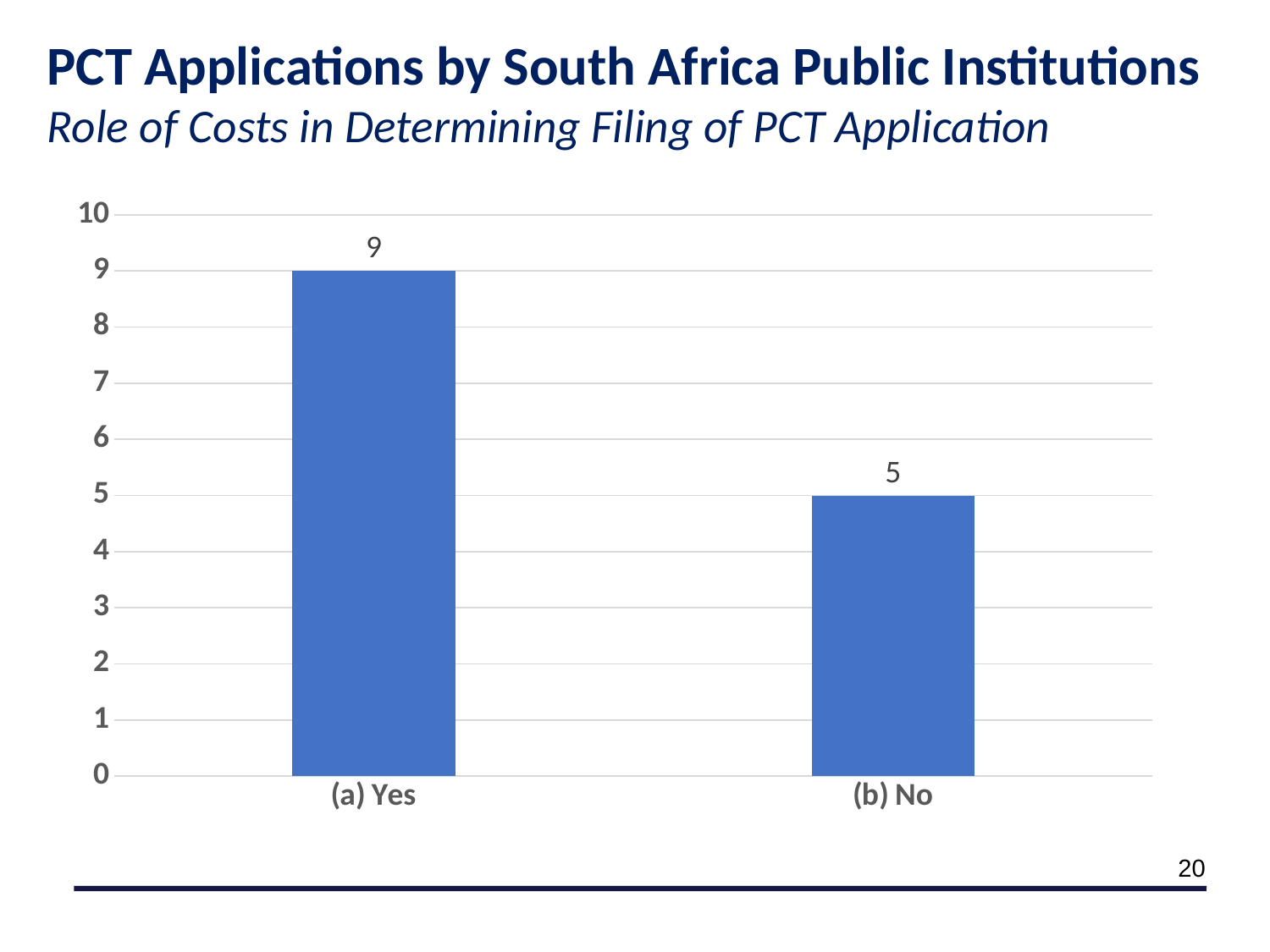
Is the value for (b) No greater or less than 6? less What kind of chart is shown on the slide? bar chart How many categories are shown on the x axis? 2 Which category has the highest value? (a) Yes Which category has the lowest value? (b) No Is the value for (a) Yes greater or less than 8? greater What is the value for (a) Yes? 9 What is the maximum value shown on the y axis? 10 What is the value for (b) No? 5 What is the subtitle of the slide describing the chart? Role of Costs in Determining Filing of PCT Application Which is larger, the value for (a) Yes or the value for (b) No? (a) Yes What is the difference between the values for (a) Yes and (b) No? 4